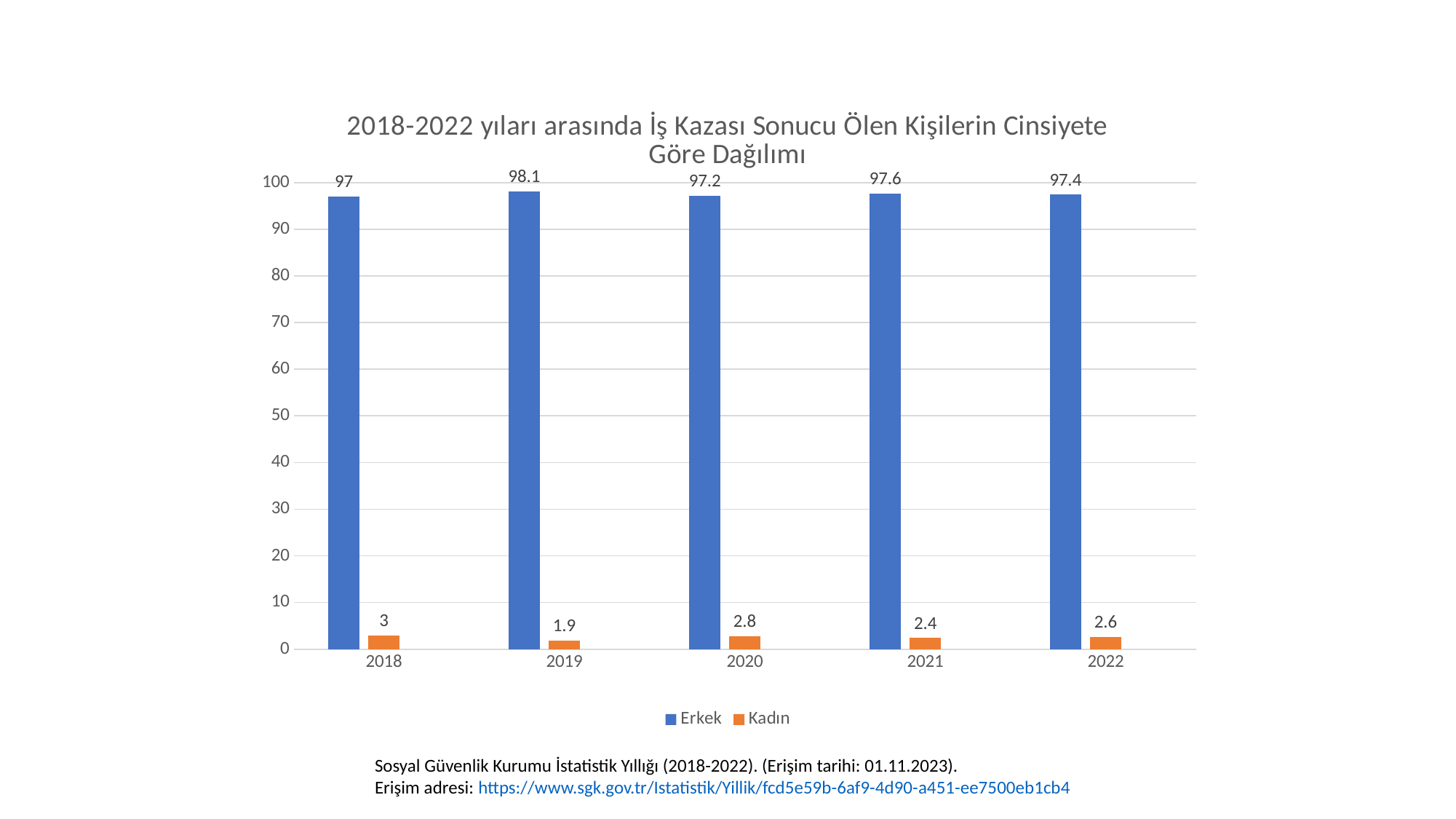
How many years are shown on the x axis? 5 What is the value for Erkek in 2018? 97 Which colour represents the Kadın series? orange What is the value for Kadın in 2020? 2.8 What kind of chart is shown on the slide? bar chart In which year is the Erkek value highest? 2019 What is the difference between the Erkek and Kadın values in 2021? 95.2 Which is larger, the Kadın value in 2022 or the Kadın value in 2019? 2022 What is the value for Erkek in 2019? 98.1 In which year is the Kadın value lowest? 2019 In which year is the Kadın value highest? 2018 How many series does the legend list? 2